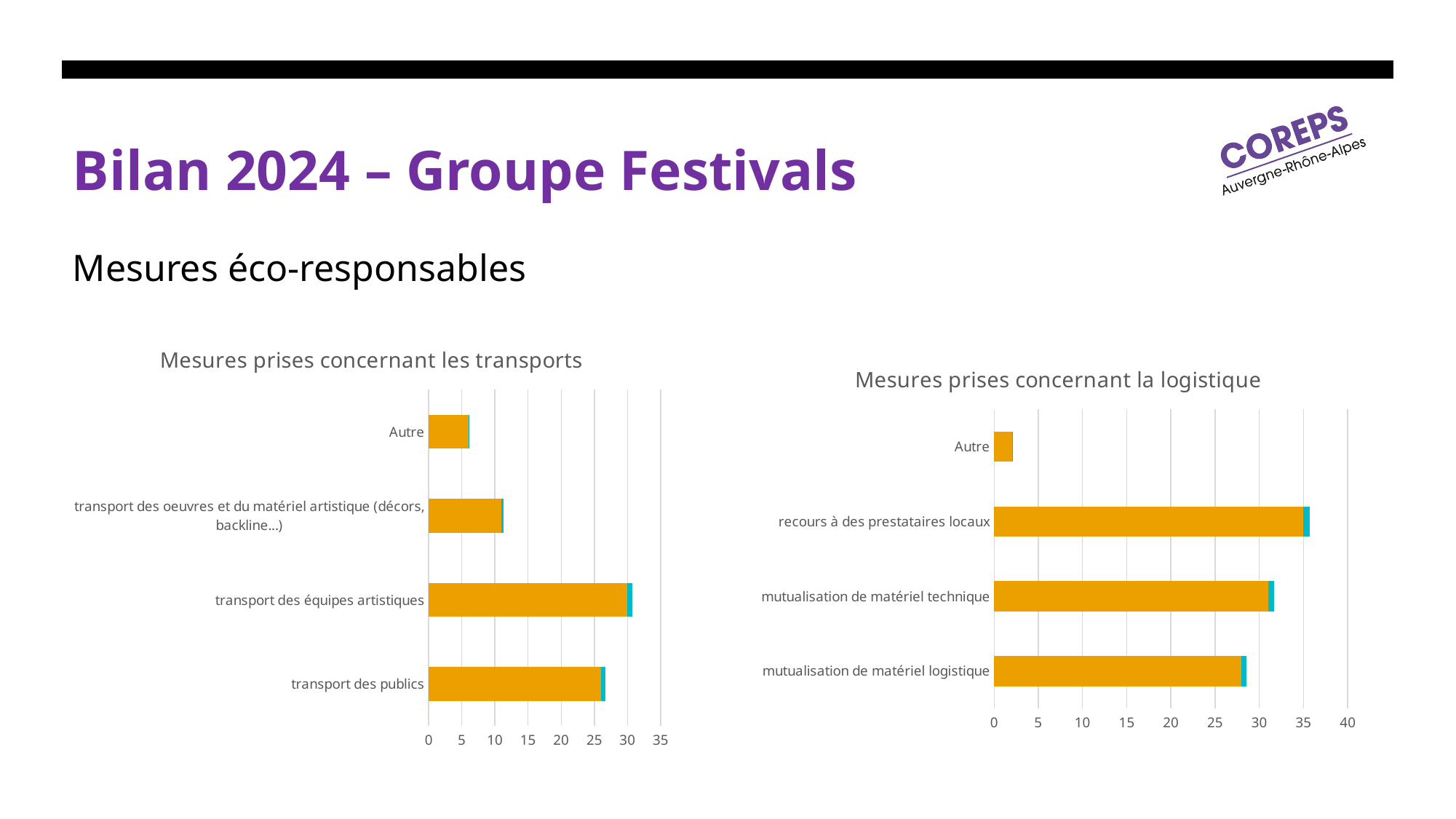
What is the title of the chart on the right side of the slide? Mesures prises concernant la logistique How many categories does the "Mesures prises concernant les transports" chart show? 4 In the "Mesures prises concernant les transports" chart, which category has the highest value? transport des équipes artistiques In the "Mesures prises concernant la logistique" chart, is the value for mutualisation de matériel logistique greater or less than 25? greater In the "Mesures prises concernant les transports" chart, which category has the lowest value? Autre In the "Mesures prises concernant les transports" chart, is the value for transport des oeuvres et du matériel artistique greater or less than 15? less What kind of chart is "Mesures prises concernant les transports"? bar chart How many categories does the "Mesures prises concernant la logistique" chart show? 4 In the "Mesures prises concernant la logistique" chart, which category has the lowest value? Autre In the "Mesures prises concernant la logistique" chart, which category has the highest value? recours à des prestataires locaux In the "Mesures prises concernant les transports" chart, is the value for transport des publics greater or less than 25? greater In the "Mesures prises concernant les transports" chart, which is larger: transport des publics or transport des équipes artistiques? transport des équipes artistiques